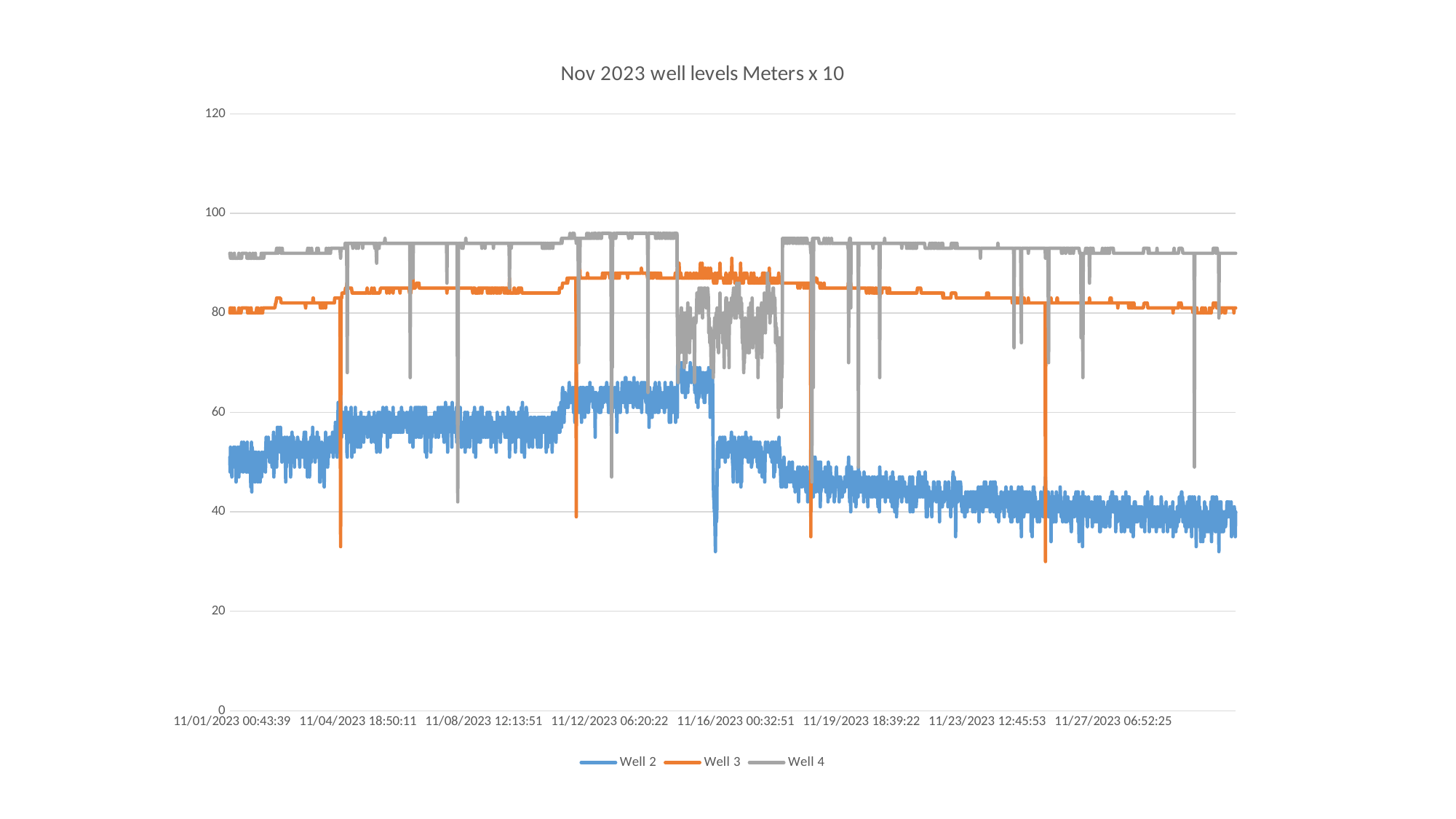
Does the Well 2 line overall rise or fall from the start of the chart to the end? fall How many date labels are shown along the x axis? 8 Which series is drawn in orange? Well 3 At 11/27/2023 06:52:25, which is larger, Well 3 or Well 2? Well 3 What kind of chart is shown on the slide? line chart Is the value for Well 2 at 11/01/2023 00:43:39 greater or less than 60? less Which series generally has the highest values across the chart? Well 4 Is the value for Well 3 at 11/01/2023 00:43:39 greater or less than 60? greater How many series does the legend list? 3 What is the title of the chart? Nov 2023 well levels Meters x 10 Which series generally has the lowest values across the chart? Well 2 Is the value for Well 4 at 11/27/2023 06:52:25 greater or less than 80? greater